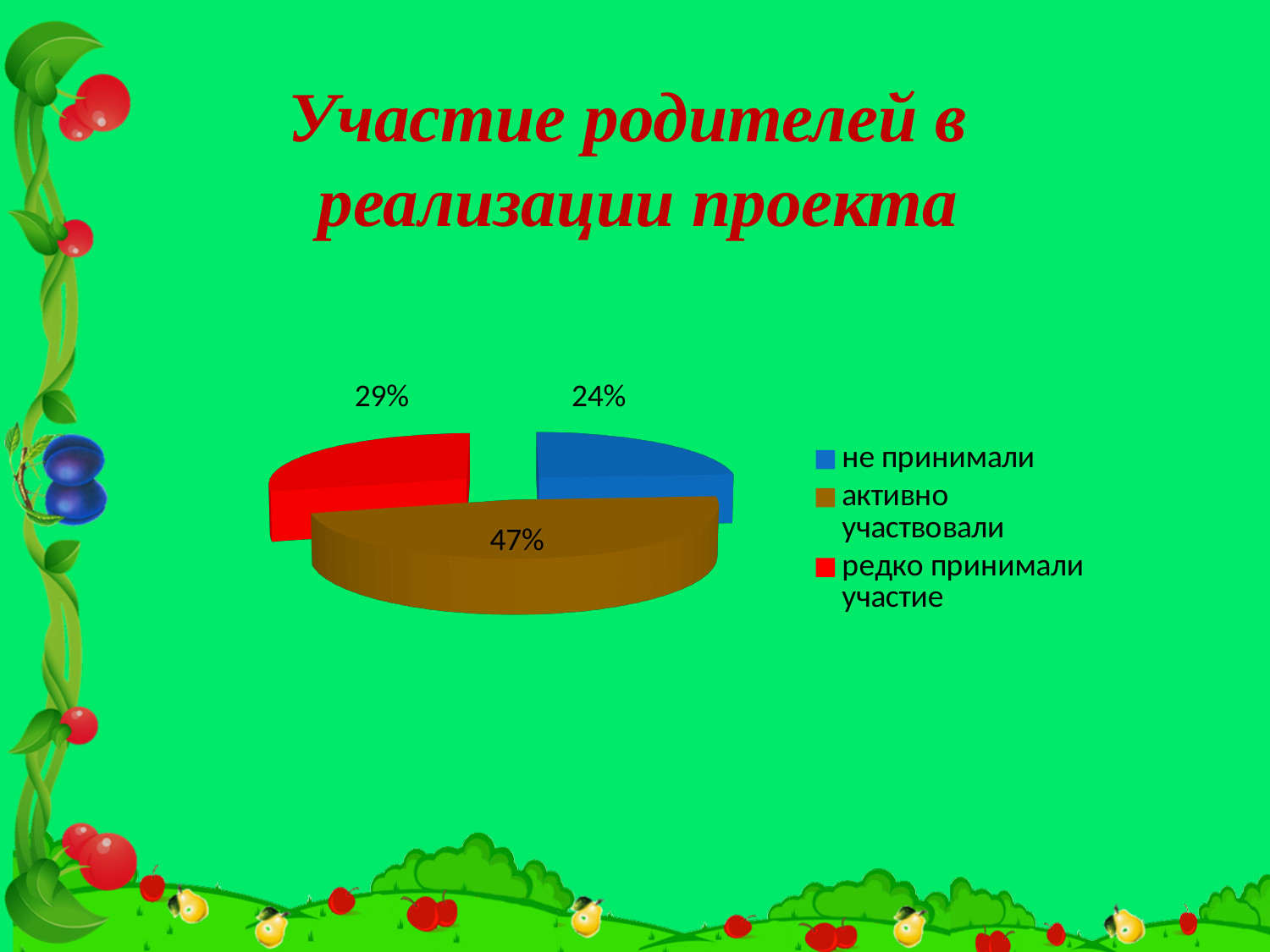
How many slices does the pie chart have? 3 What is the difference in percentage points between "активно участвовали" and "не принимали"? 23 Which is larger: the slice for "редко принимали участие" or the slice for "не принимали"? редко принимали участие What is the title of the slide containing the chart? Участие родителей в реализации проекта What share of the pie is labelled "не принимали"? 24% What colour is the slice for "активно участвовали"? brown What share of the pie is labelled "активно участвовали"? 47% What share of the pie is labelled "редко принимали участие"? 29% What kind of chart is shown on the slide? pie chart Which category has the smallest slice of the pie? не принимали Which category has the largest slice of the pie? активно участвовали What is the difference in percentage points between "редко принимали участие" and "не принимали"? 5